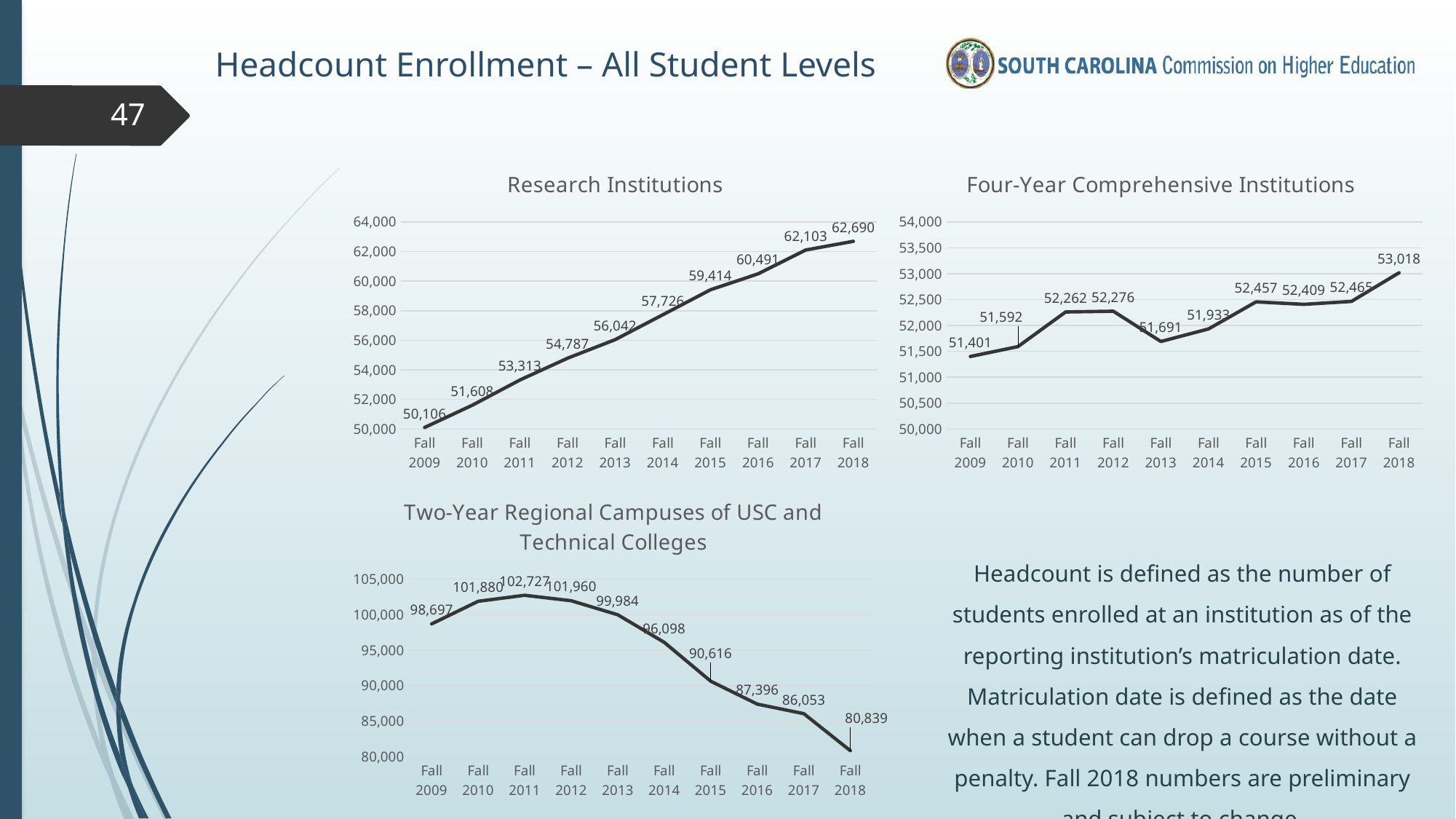
In the Research Institutions chart, what is the headcount for Fall 2018? 62,690 In the Research Institutions chart, do the values rise or fall from Fall 2009 to Fall 2018? rise In the Four-Year Comprehensive Institutions chart, which year has the lowest headcount? Fall 2009 How many data points are plotted in the Two-Year Regional Campuses of USC and Technical Colleges chart? 10 In the Research Institutions chart, by how much did the headcount increase from Fall 2009 to Fall 2018? 12,584 In the Two-Year Regional Campuses of USC and Technical Colleges chart, which year has the highest headcount? Fall 2011 In the Four-Year Comprehensive Institutions chart, which year has the highest headcount? Fall 2018 In the Two-Year Regional Campuses of USC and Technical Colleges chart, what is the headcount for Fall 2018? 80,839 In the Research Institutions chart, what is the headcount for Fall 2009? 50,106 In the Four-Year Comprehensive Institutions chart, what is the headcount for Fall 2013? 51,691 In the Two-Year Regional Campuses of USC and Technical Colleges chart, what is the difference between the Fall 2011 and Fall 2018 headcounts? 21,888 What type of chart is the Research Institutions chart? line chart